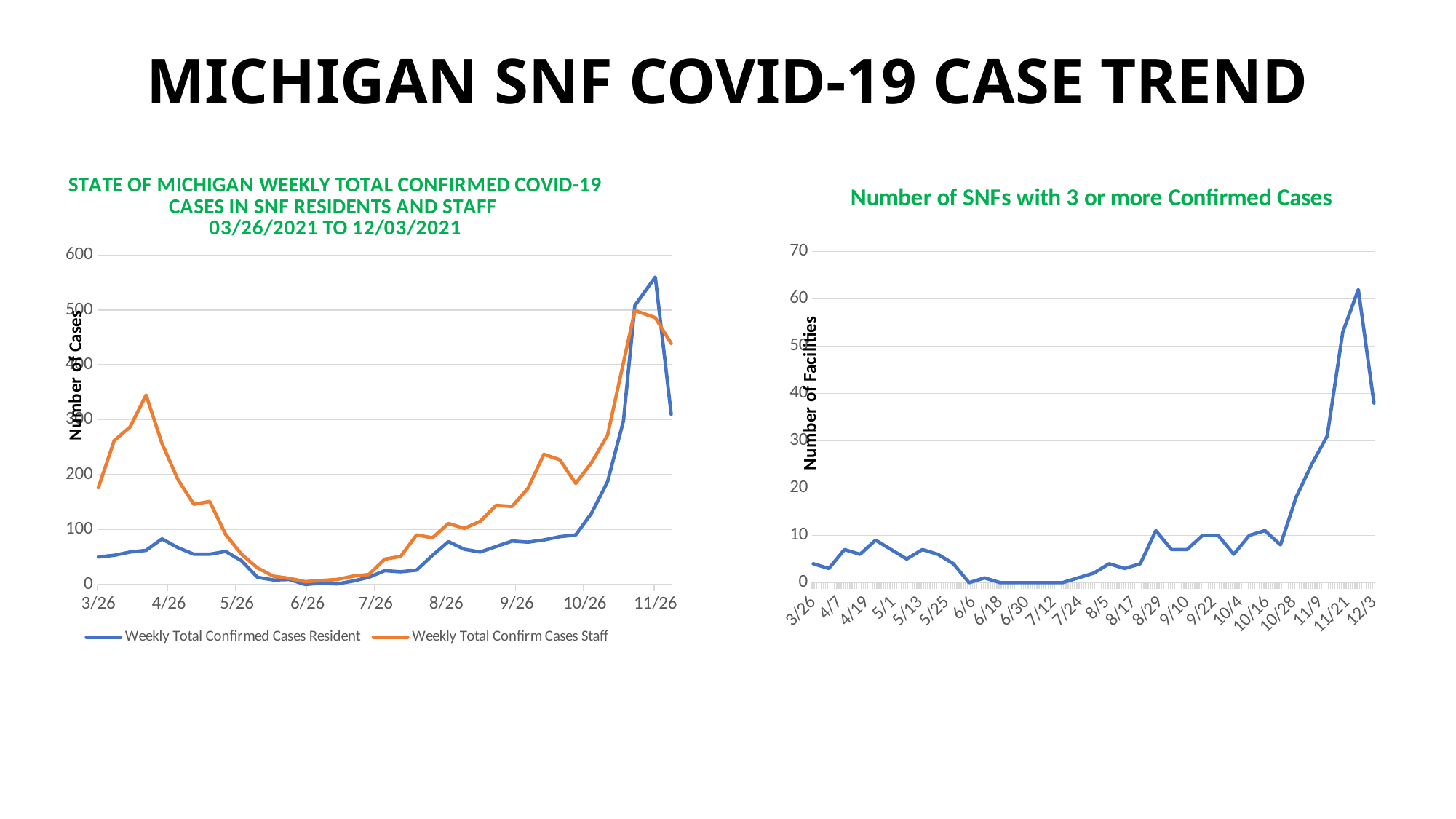
In the left chart, at 11/26, which series has the larger value: Weekly Total Confirmed Cases Resident or Weekly Total Confirm Cases Staff? Weekly Total Confirmed Cases Resident What kind of chart is the left chart titled 'State of Michigan Weekly Total Confirmed COVID-19 Cases in SNF Residents and Staff'? Line chart In the right chart, what is the y-axis label? Number of Facilities In the right chart, does the number of facilities rise or fall between 10/28 and 11/21? Rise In the right chart, is the peak value of the line greater or less than 50? greater In the left chart, how many series does the legend list? 2 In the left chart, what are the two series named in the legend? Weekly Total Confirmed Cases Resident; Weekly Total Confirm Cases Staff What kind of chart is the right chart titled 'Number of SNFs with 3 or more Confirmed Cases'? Line chart In the left chart, is the Weekly Total Confirm Cases Staff value at 6/26 greater or less than 100? less In the right chart, is the value at 6/18 greater or less than 10? less In the left chart, at 3/26, which series has the larger value: Weekly Total Confirmed Cases Resident or Weekly Total Confirm Cases Staff? Weekly Total Confirm Cases Staff